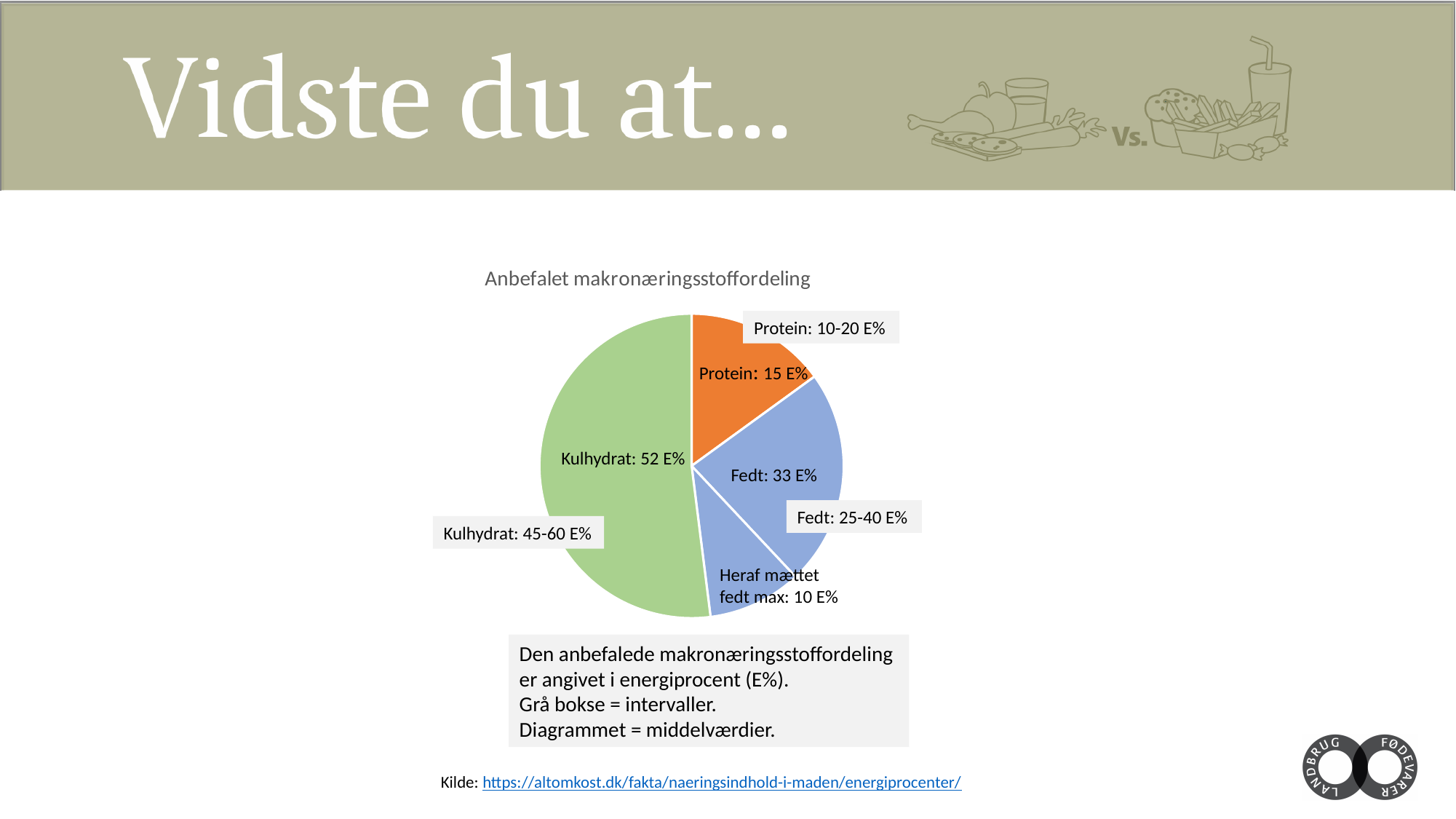
What is the value for Fedt in the pie chart? 33 E% Which of the three macronutrients (Protein, Fedt, Kulhydrat) has the smallest slice? Protein Which macronutrient has the largest slice in the pie chart? Kulhydrat What interval is shown in the grey box for Protein? 10-20 E% What is the difference between the Kulhydrat and Fedt values in the pie chart? 19 E% Which is larger in the pie chart, Fedt or Protein? Fedt What is the title of the pie chart? Anbefalet makronæringsstoffordeling What is the maximum value given for saturated fat (mættet fedt) in the chart? 10 E% What is the value for Protein in the pie chart? 15 E% What is the value for Kulhydrat in the pie chart? 52 E% What kind of chart is shown on the slide? pie chart What is the difference between the Fedt and Protein values in the pie chart? 18 E%